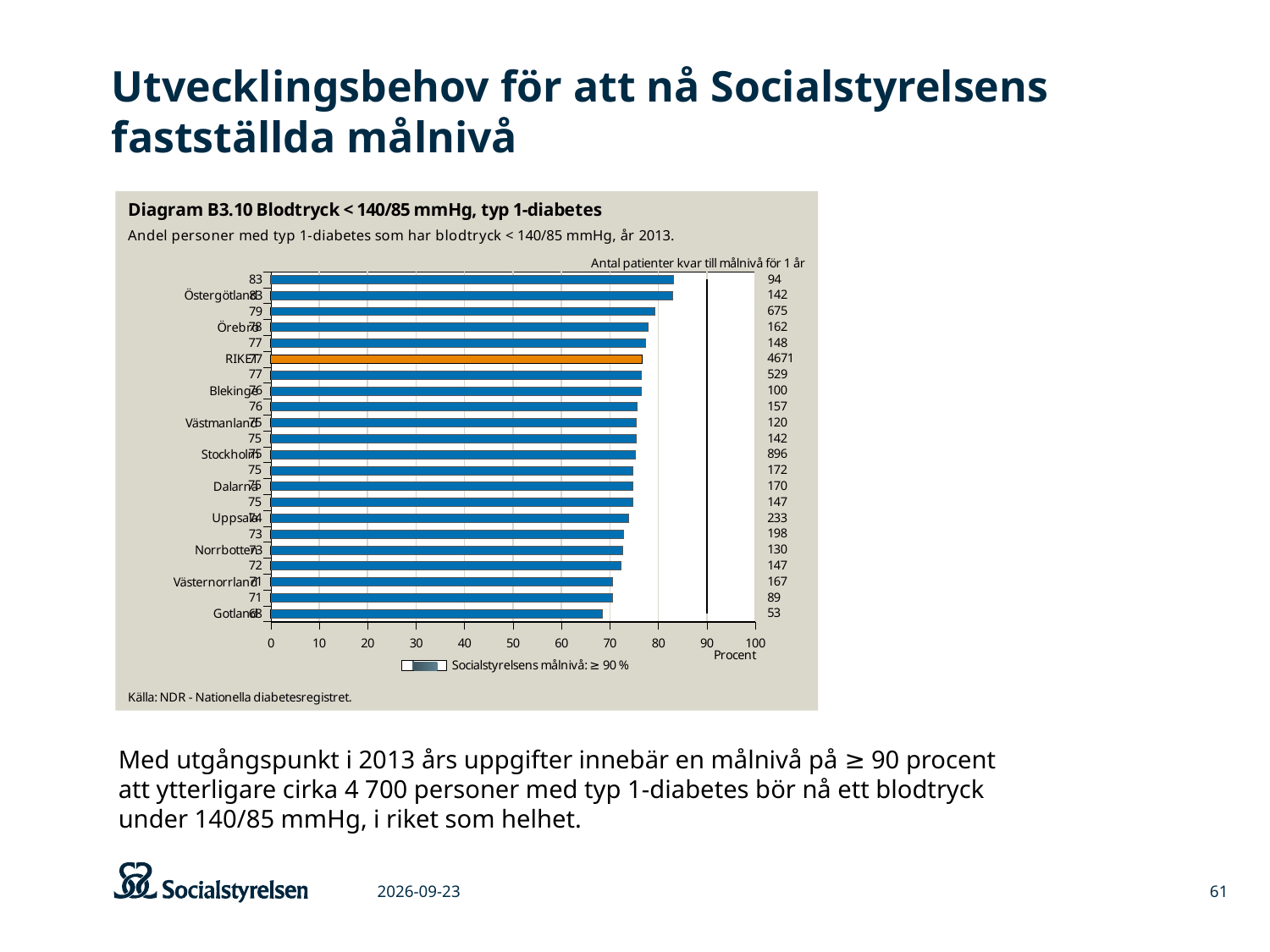
What is the value for Östergötland in the chart? 83 Is the value for RIKET greater or less than 90? less What kind of chart is shown on the slide? bar chart How many bars are plotted in the chart? 22 What is the difference between the values for Östergötland and Gotland? 15 Which category has the lowest value in the chart? Gotland What is the value for Örebro in the chart? 78 What is the value for RIKET in the chart? 77 What is the title of the diagram shown on the slide? Diagram B3.10 Blodtryck < 140/85 mmHg, typ 1-diabetes According to the column 'Antal patienter kvar till målnivå för 1 år', how many patients remain for RIKET? 4671 What is the value for Gotland in the chart? 68 Which has a larger value, Örebro or Uppsala? Örebro